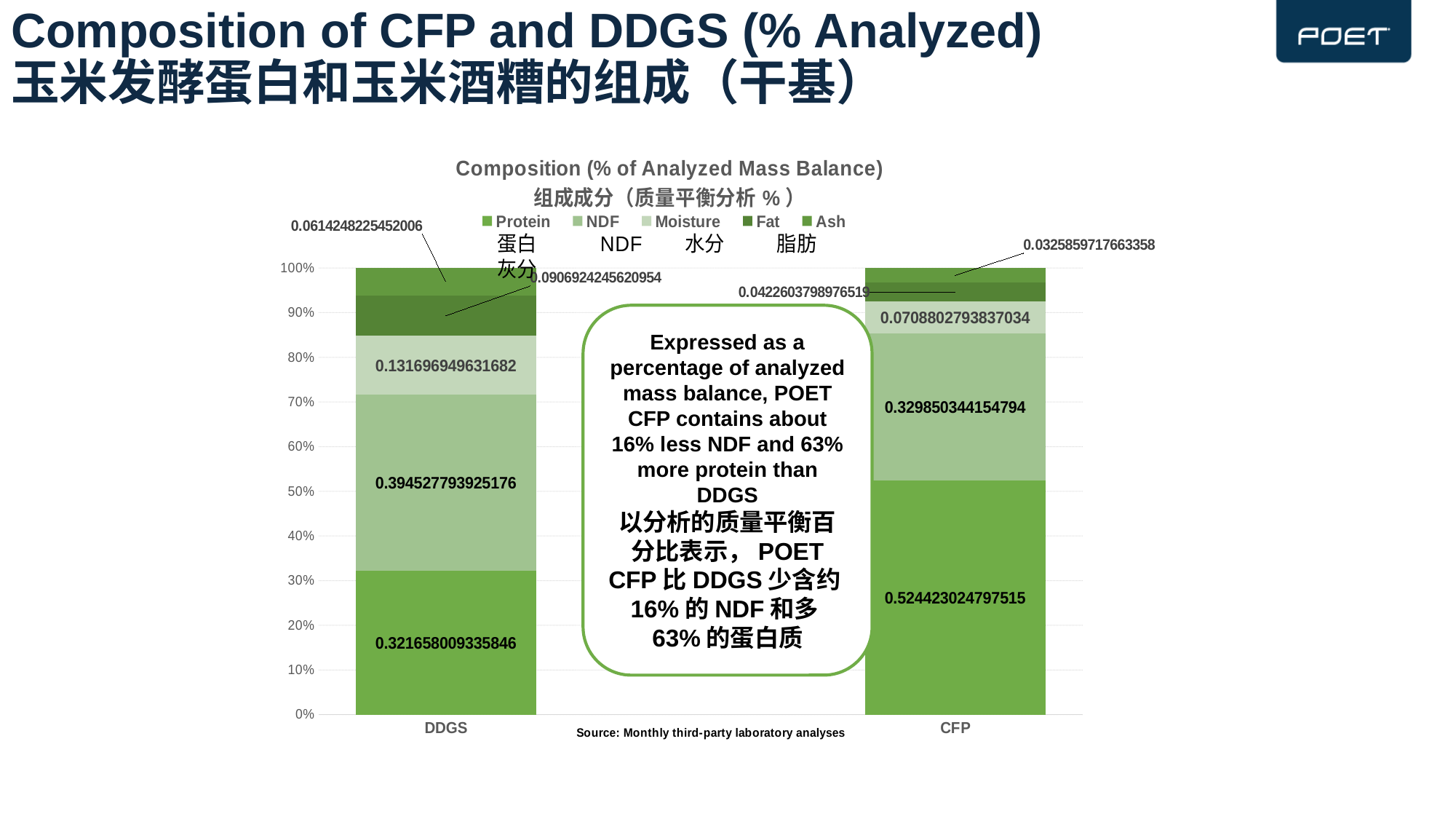
Which has the higher Protein value, DDGS or CFP? CFP What is the Protein value for CFP? 0.524423024797515 What is the Ash value for CFP? 0.0325859717663358 What is the Protein value for DDGS? 0.321658009335846 How many series does the legend list? 5 Which component makes up the largest share of the DDGS bar? NDF What is the NDF value for DDGS? 0.394527793925176 What kind of chart is shown on the slide? Stacked bar chart What is the Moisture value for CFP? 0.0708802793837034 Which has the higher NDF value, DDGS or CFP? DDGS What is the Fat value for DDGS? 0.0906924245620954 Which component makes up the largest share of the CFP bar? Protein